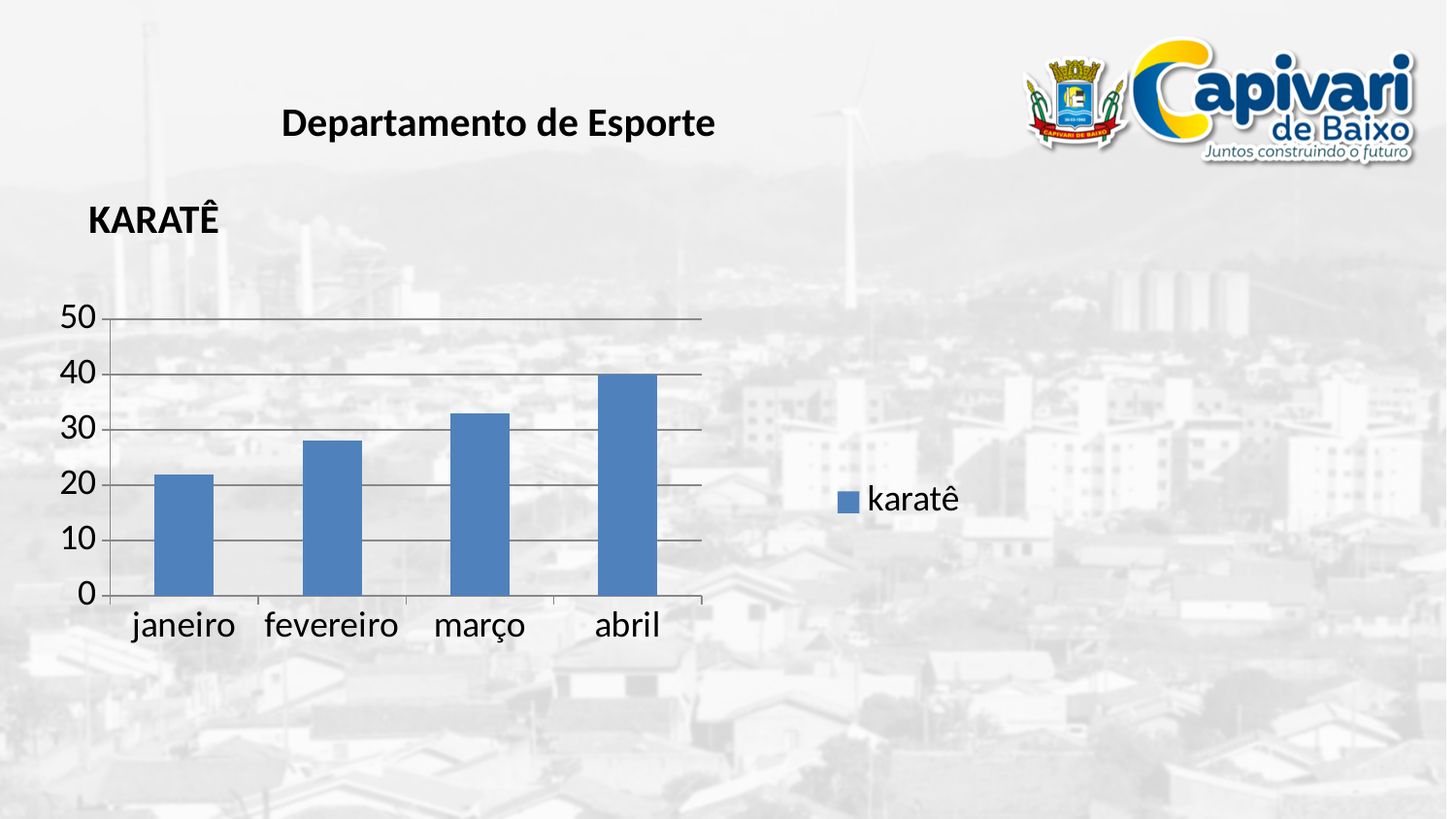
Which month has the lowest value in the KARATÊ chart? janeiro Is the value for janeiro greater or less than 30? less How many series does the legend of the KARATÊ chart list? 1 What is the name of the series shown in the legend of the chart? karatê Do the values rise or fall from janeiro to abril in the KARATÊ chart? rise What kind of chart is shown on the slide? bar chart Is the value for janeiro greater or less than 20? greater How many months are shown on the x axis of the KARATÊ chart? 4 Is the value for março greater or less than 30? greater Which month has the highest value in the KARATÊ chart? abril Which is larger, the value for março or the value for fevereiro? março